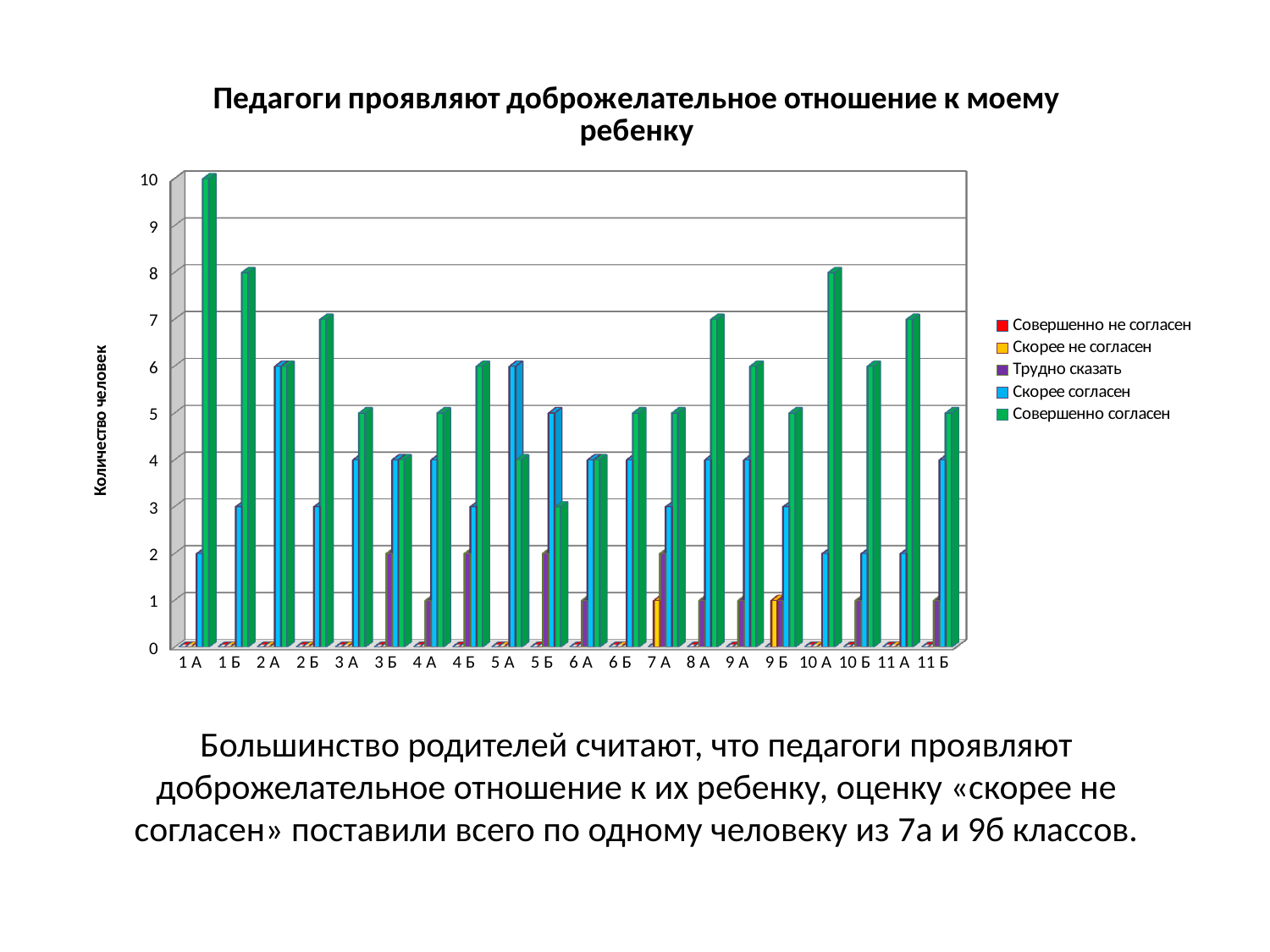
Which class has the highest value for "Совершенно согласен"? 1 А Which is larger for class 5 А: "Скорее согласен" or "Совершенно согласен"? Скорее согласен What is the value of "Скорее согласен" for class 2 А? 6 What is the value of "Совершенно согласен" for class 1 А? 10 How many series does the legend list? 5 What is the label of the vertical axis? Количество человек What is the difference between "Совершенно согласен" for 1 А and for 10 А? 2 Is the value of "Совершенно согласен" for class 8 А greater or less than 5? greater What is the value of "Совершенно согласен" for class 1 Б? 8 How many class categories are shown on the x axis? 20 What type of chart is shown on the slide? bar chart What is the title of the chart? Педагоги проявляют доброжелательное отношение к моему ребенку